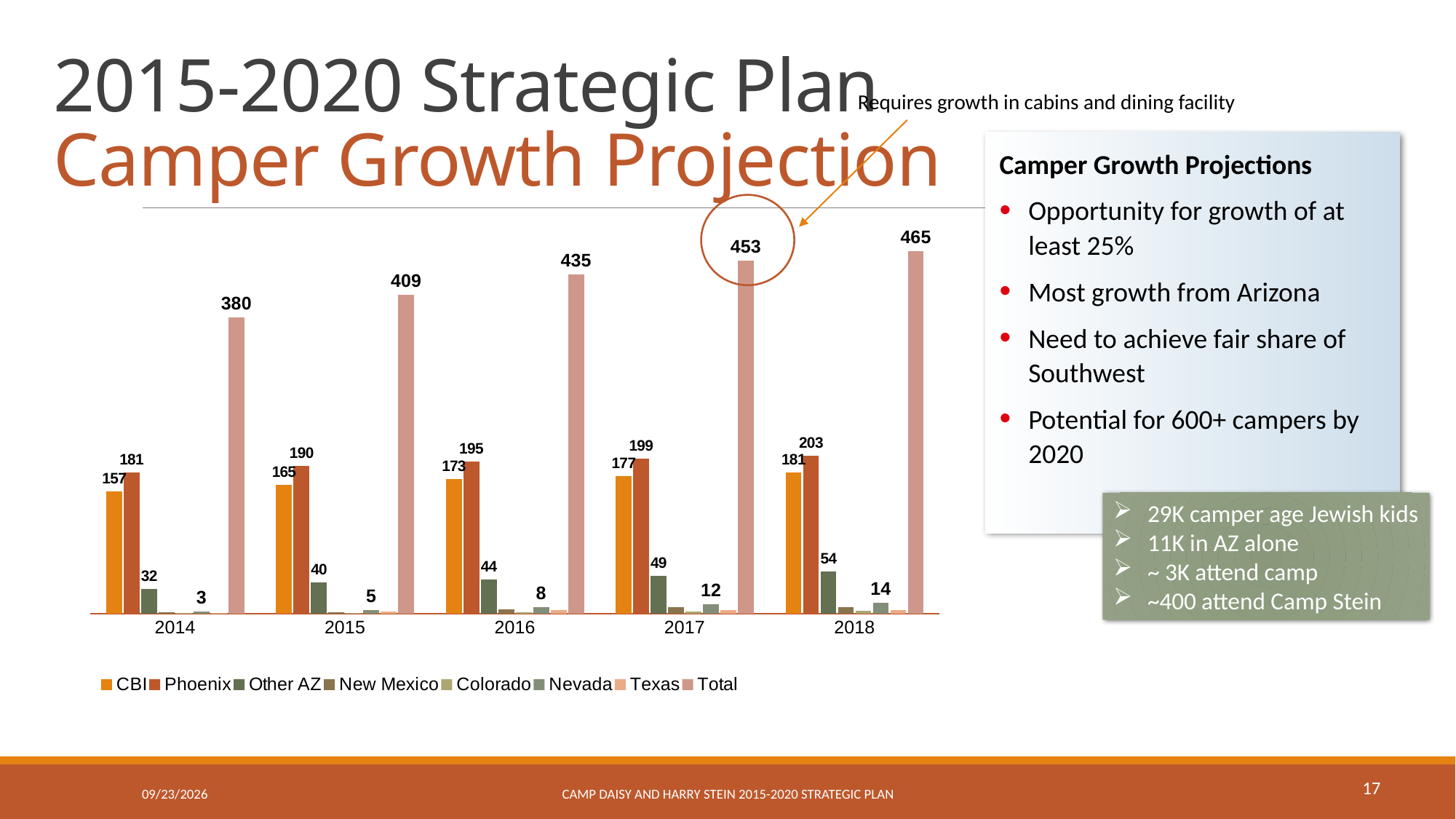
How many series does the legend list? 8 What is the Total value for 2016? 435 What is the difference between the Total values for 2018 and 2014? 85 What is the Other AZ value for 2017? 49 In which year is the Total value highest? 2018 Do the Total values rise or fall from 2014 to 2018? Rise In which year is the Nevada value lowest? 2014 Which is larger in 2015, the CBI value or the Phoenix value? Phoenix What kind of chart is shown on the slide? Bar chart What is the Phoenix value for 2018? 203 What is the CBI value for 2014? 157 How many years are shown on the x axis? 5